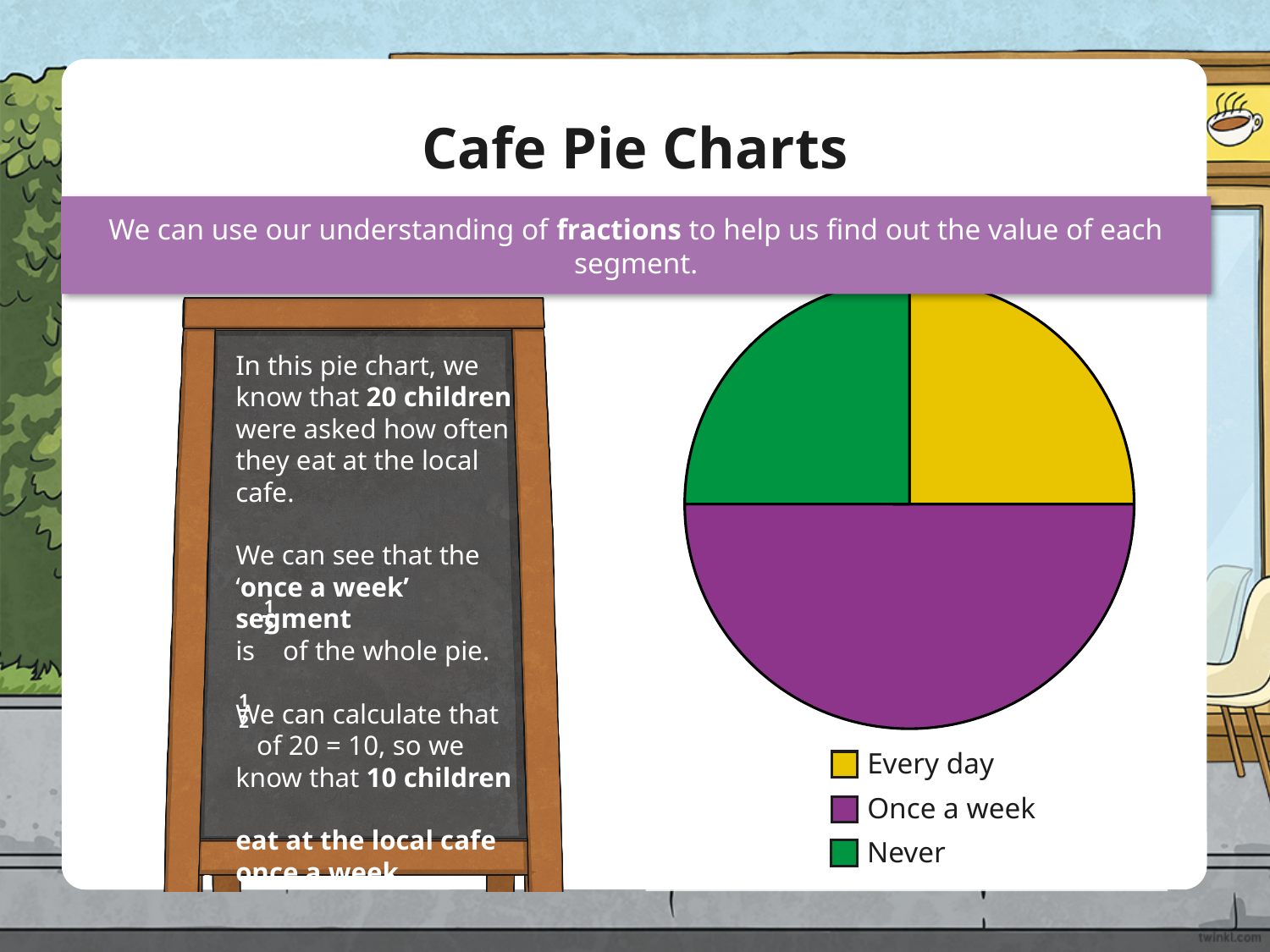
How many segments does the pie chart have? 3 Which segment of the pie chart is the largest? Once a week What is the title of the slide containing the pie chart? Cafe Pie Charts What fraction of the whole pie is the 'Once a week' segment? 1/2 Which is larger in the pie chart, the 'Once a week' segment or the 'Never' segment? Once a week What kind of chart is shown on the slide? pie chart Which is larger in the pie chart, the 'Once a week' segment or the 'Every day' segment? Once a week According to the slide, how many children eat at the local cafe once a week? 10 What colour represents 'Never' in the pie chart? green According to the slide, how many children were asked how often they eat at the local cafe? 20 How many entries does the legend of the pie chart list? 3